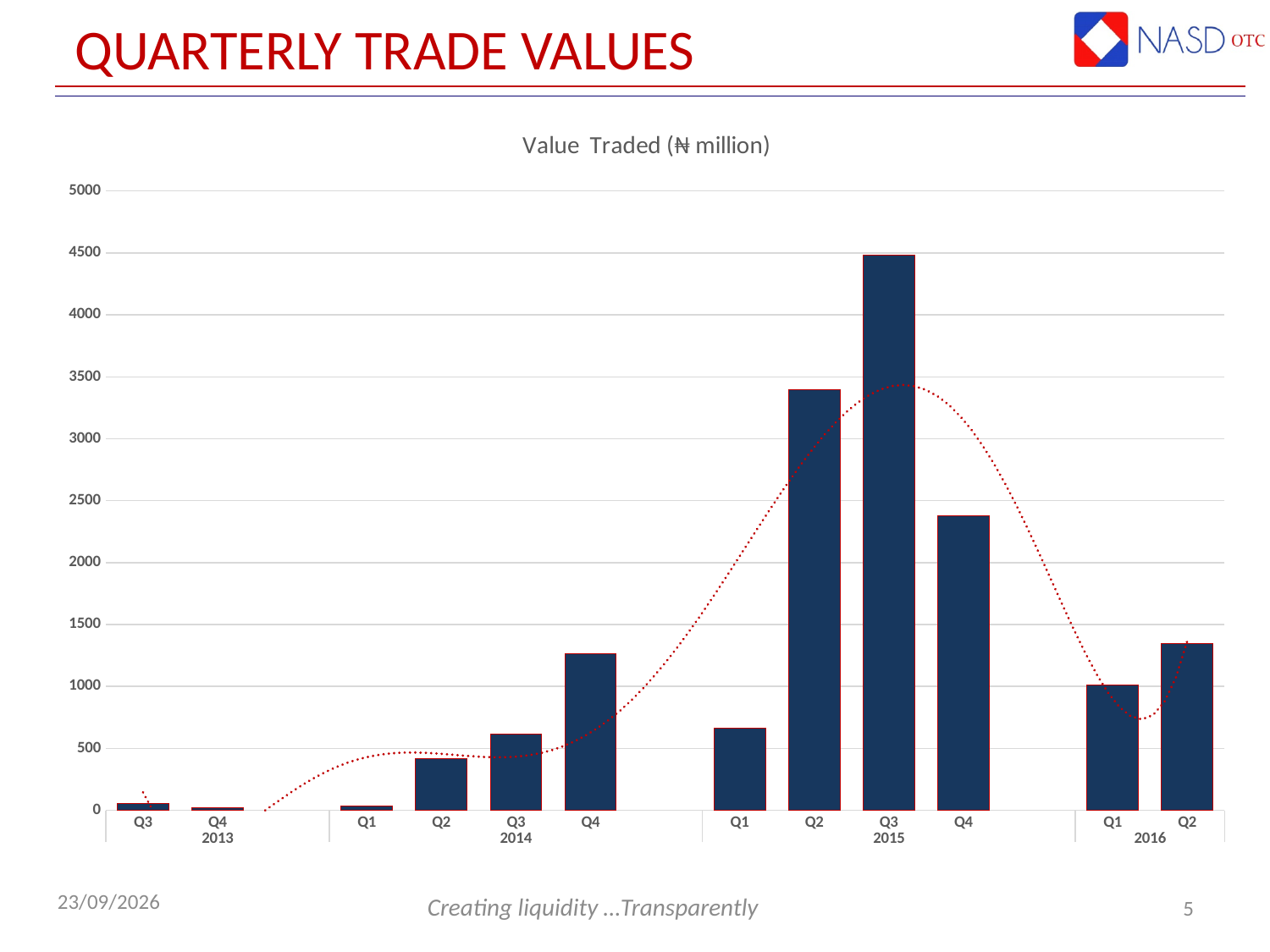
Is the value traded for Q4 2015 greater or less than 2500? less How many quarterly bars are plotted in the chart? 12 Is the value traded for Q2 2015 greater or less than 3000? greater Do the values rise or fall from Q1 2015 to Q3 2015? rise Is the value traded for Q2 2014 greater or less than 500? less Which is larger, the value traded in Q4 2014 or in Q1 2015? Q4 2014 Which quarter has the highest value traded? Q3 2015 What is the title of the chart? Value Traded (₦ million) Which is larger, the value traded in Q2 2015 or in Q4 2015? Q2 2015 What kind of chart is shown on the slide? bar chart